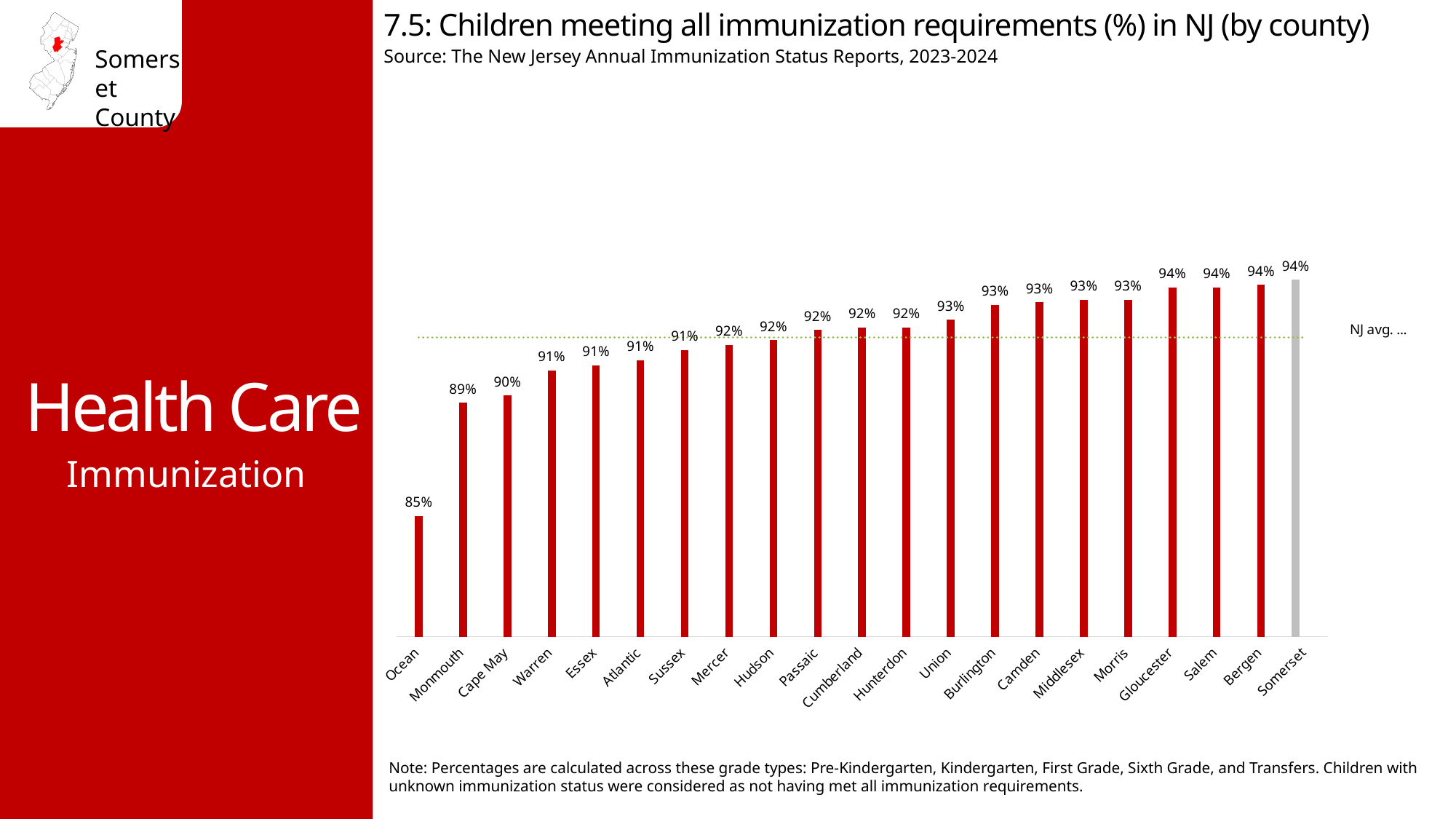
How many counties are shown on the chart? 21 What is the value shown for Union County? 93% What is the difference in percentage points between Somerset County and Ocean County? 9 percentage points What kind of chart is shown on the slide? Bar chart Which has a higher value, Ocean County or Monmouth County? Monmouth Which county has the lowest percentage of children meeting all immunization requirements? Ocean What is the value shown for Somerset County? 94% What is the value shown for Cape May County? 90% Do the values generally rise or fall moving from left to right along the x axis? Rise What percentage of children in Ocean County met all immunization requirements? 85% What is the value shown for Monmouth County? 89% Which county's bar is coloured grey instead of red? Somerset